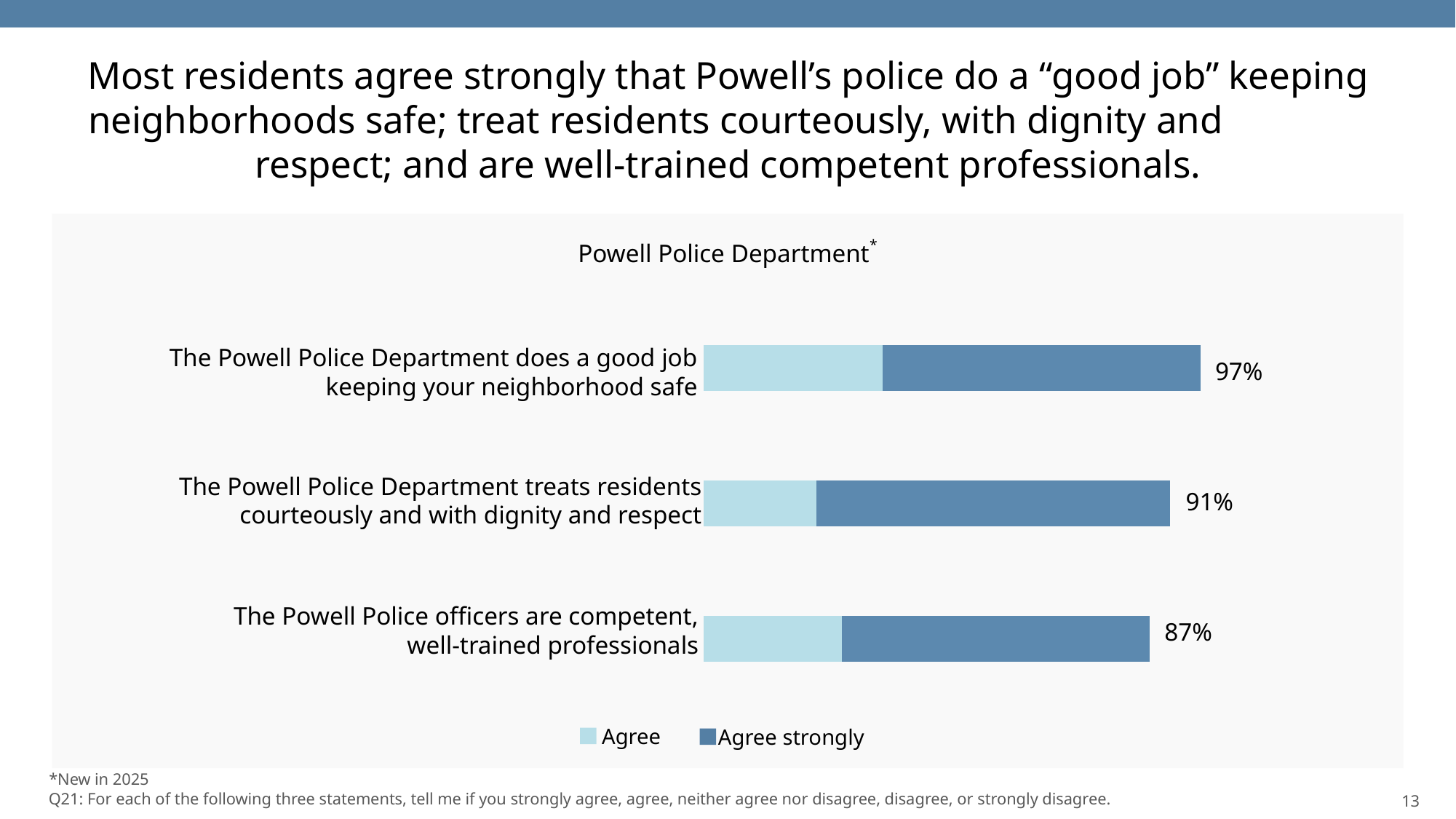
What is the difference in total percentage between the "treats residents courteously" statement and the "competent, well-trained professionals" statement? 4% What is the total percentage shown for "The Powell Police officers are competent, well-trained professionals"? 87% What is the difference in total percentage between the "good job keeping your neighborhood safe" statement and the "competent, well-trained professionals" statement? 10% How many statements are plotted in the chart? 3 What is the total percentage shown for "The Powell Police Department does a good job keeping your neighborhood safe"? 97% Which has a larger total percentage: the "treats residents courteously and with dignity and respect" statement or the "competent, well-trained professionals" statement? The Powell Police Department treats residents courteously and with dignity and respect Which statement has the lowest total percentage? The Powell Police officers are competent, well-trained professionals What is the title of the chart? Powell Police Department What kind of chart is shown on the slide? Stacked bar chart How many series does the legend list? 2 Which statement has the highest total percentage? The Powell Police Department does a good job keeping your neighborhood safe What is the total percentage shown for "The Powell Police Department treats residents courteously and with dignity and respect"? 91%